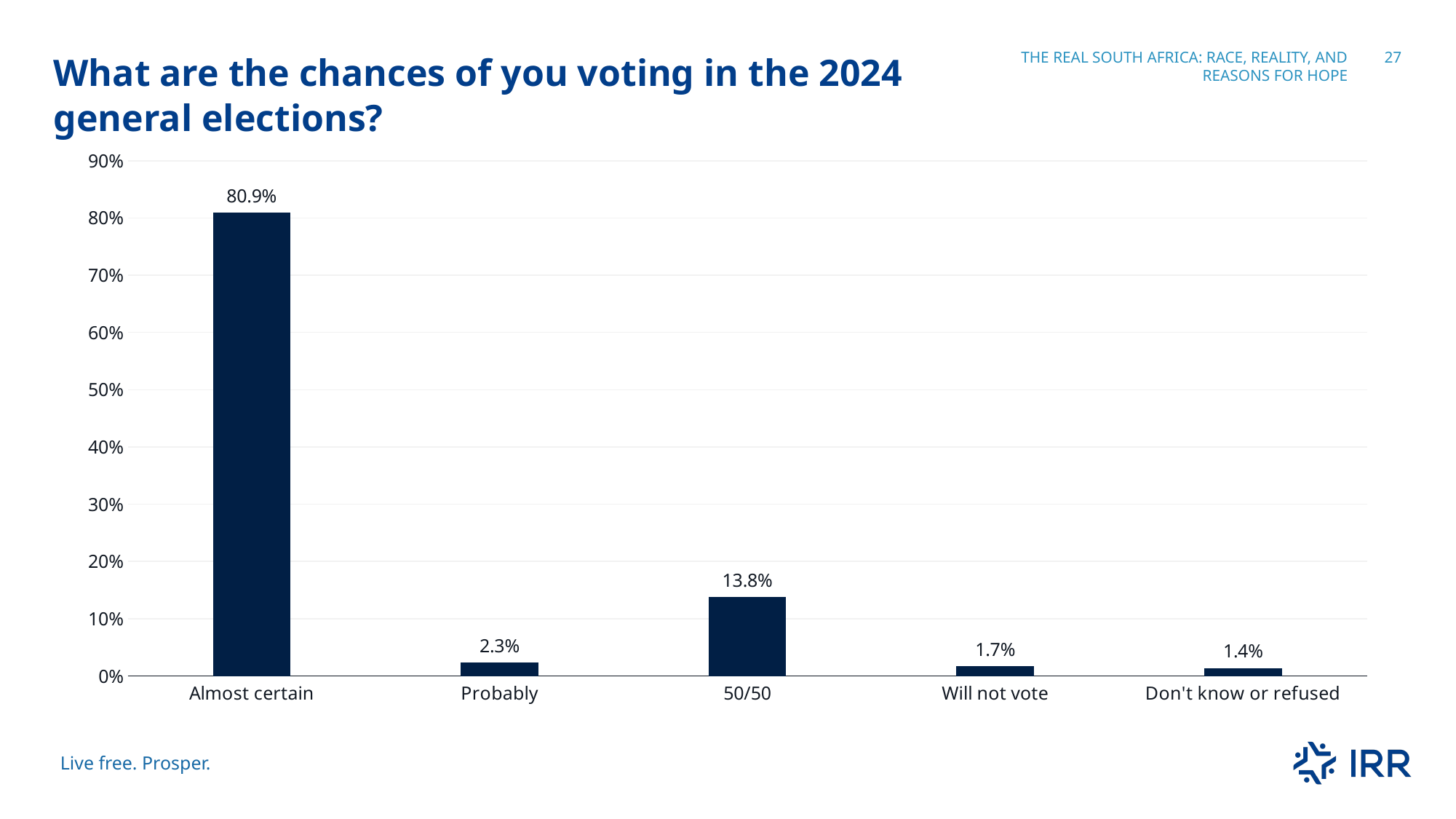
What percentage of respondents said they will not vote? 1.7% What is the difference between the 'Almost certain' and '50/50' values? 67.1 percentage points What kind of chart is shown on the slide? Bar chart What is the value shown for the 50/50 category? 13.8% Is the value for 'Almost certain' greater or less than 80%? greater What is the value for 'Don't know or refused'? 1.4% Which is larger, the value for 'Probably' or the value for '50/50'? 50/50 What percentage of respondents said they are almost certain to vote in the 2024 general elections? 80.9% What is the highest value shown on the y axis? 90% How many categories are shown on the x axis? 5 Which category has the lowest value? Don't know or refused Which category has the highest value? Almost certain